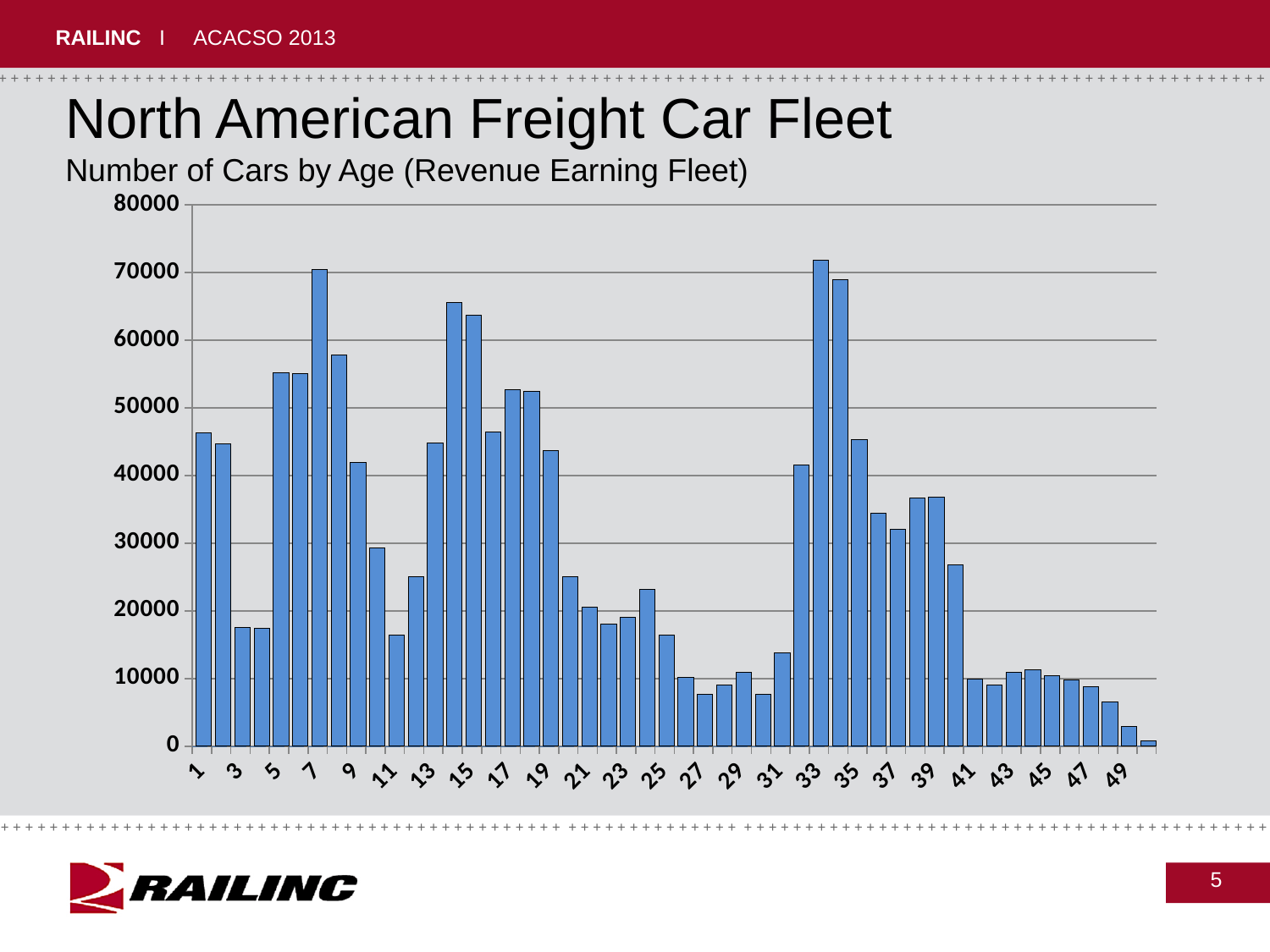
Is the value for age 27 greater or less than 10000? less Which has the larger value, age 1 or age 3? age 1 Is the value for age 41 greater or less than 20000? less Is the value for age 1 greater or less than 40000? greater Which age has the lowest number of cars? 50 What is the subtitle shown under the chart title? Number of Cars by Age (Revenue Earning Fleet) What kind of chart is shown on the slide? bar chart Do the values rise or fall from age 33 to age 41? fall What is the title of the chart on the slide? North American Freight Car Fleet